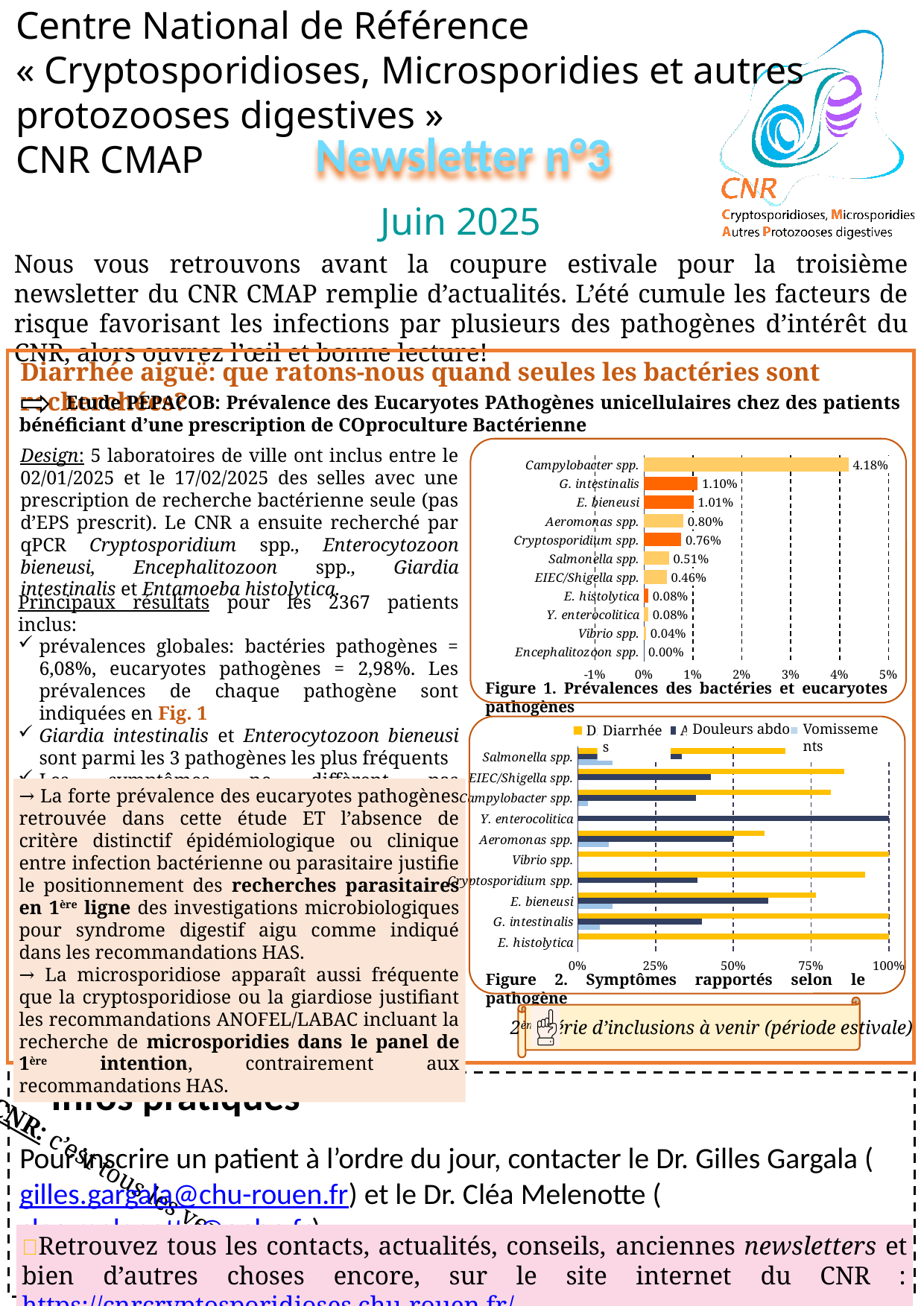
How many series does the legend of Figure 2 list? 3 In Figure 1, what is the prevalence shown for Cryptosporidium spp.? 0.76% What kind of chart is Figure 1? Bar chart In Figure 1, what is the prevalence shown for Campylobacter spp.? 4.18% In Figure 1, which has the higher prevalence, Aeromonas spp. or EIEC/Shigella spp.? Aeromonas spp. In Figure 1, what is the difference between the prevalence of E. bieneusi and that of Salmonella spp.? 0.50% In Figure 2, is the Diarrhée value for Salmonella spp. greater or less than 50%? greater In Figure 1, what is the prevalence shown for G. intestinalis? 1.10% How many pathogens are plotted in Figure 1? 11 In Figure 1, which pathogen has the lowest prevalence? Encephalitozoon spp. In Figure 1, which pathogen has the highest prevalence? Campylobacter spp. In Figure 2, is the Vomissements value for Salmonella spp. greater or less than 25%? less